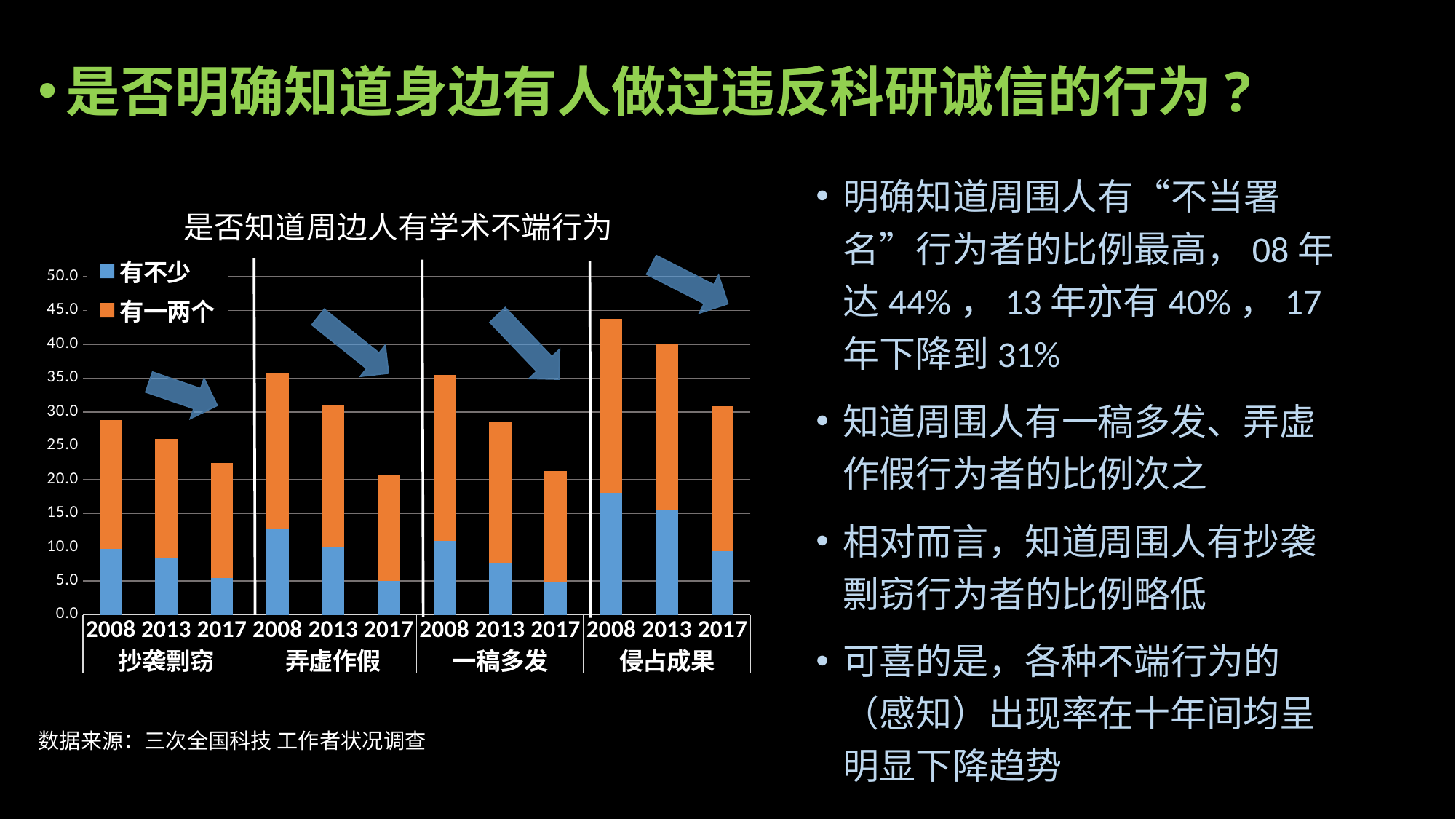
Which bar has the highest total in the chart? 侵占成果 2008 Is the total for 抄袭剽窃 in 2008 greater or less than 35? less How many types of misconduct (category groups) are shown on the x axis? 4 Within each misconduct category, do the bar totals rise or fall from 2008 to 2017? fall Which series is shown in blue in the chart? 有不少 Which has the larger total in 2013, 侵占成果 or 弄虚作假? 侵占成果 Is the total for 一稿多发 in 2017 greater or less than 25? less Is the total for 侵占成果 in 2008 greater or less than 40? greater How many bars are plotted in the chart? 12 How many series does the chart legend list? 2 What is the title of the chart? 是否知道周边人有学术不端行为 What kind of chart is shown on the slide? Stacked bar chart